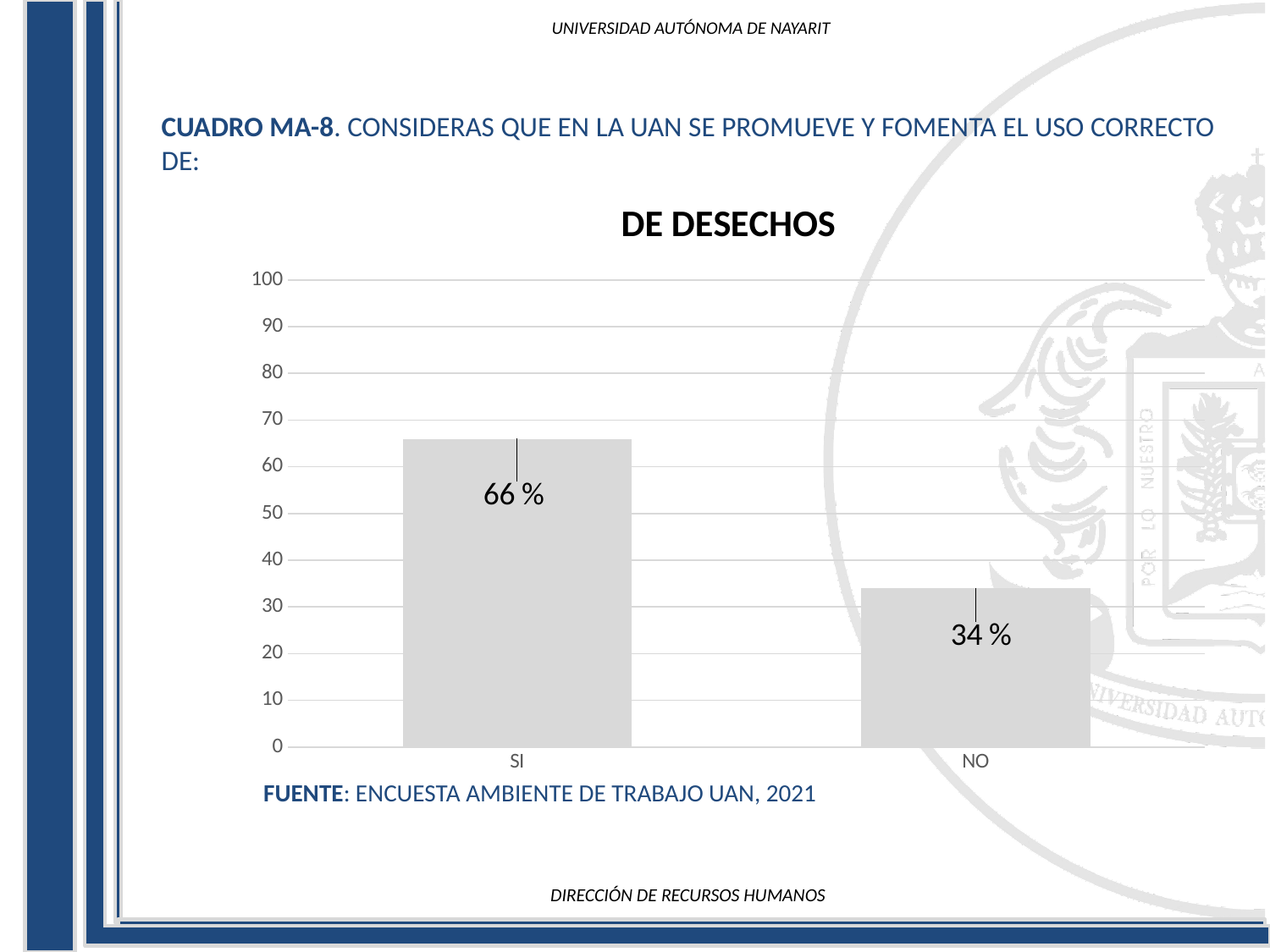
Is the value for NO greater or less than 40? less Which category has the highest value? SI What is the value for SI? 66 % How many categories are shown on the x axis? 2 What kind of chart is shown on the slide? bar chart What is the value for NO? 34 % Is the value for SI greater or less than 60? greater Which category has the lowest value? NO What is the maximum value shown on the y axis? 100 What is the difference between the values for SI and NO? 32 % What is the title of the chart? DE DESECHOS Which is larger, the value for SI or the value for NO? SI